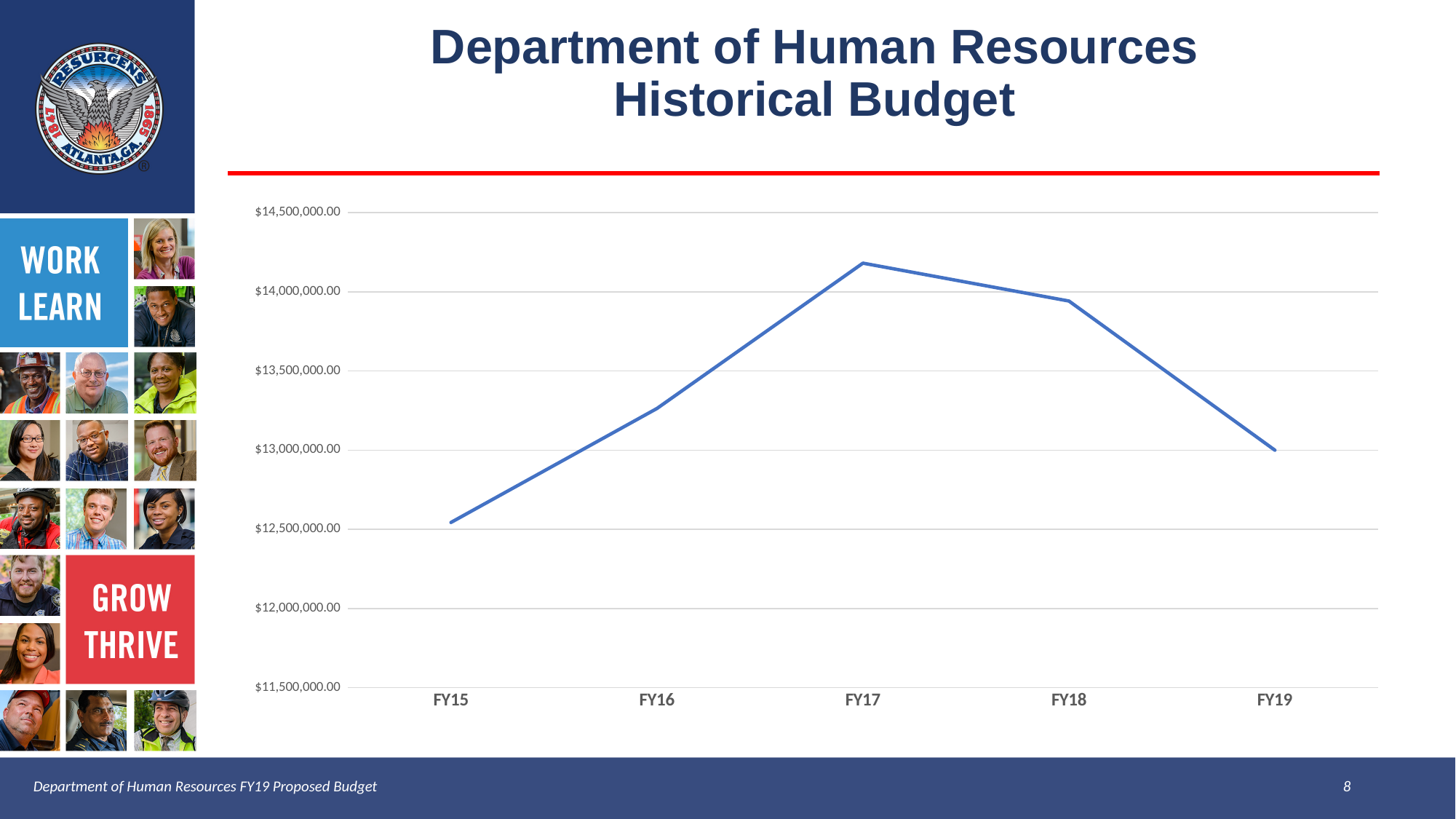
What is the title of the slide containing the chart? Department of Human Resources Historical Budget Is the value for FY15 greater or less than $13,000,000.00? less How many fiscal years are plotted on the x axis? 5 Which fiscal year has the lowest budget value? FY15 Which is larger, the value for FY16 or the value for FY18? FY18 What kind of chart is shown on the slide? Line chart How does the budget change from FY15 to FY17? It rises How does the budget change from FY17 to FY19? It falls Is the value for FY16 greater or less than $13,500,000.00? less Which fiscal year has the highest budget value? FY17 Is the value for FY18 greater or less than $13,500,000.00? greater